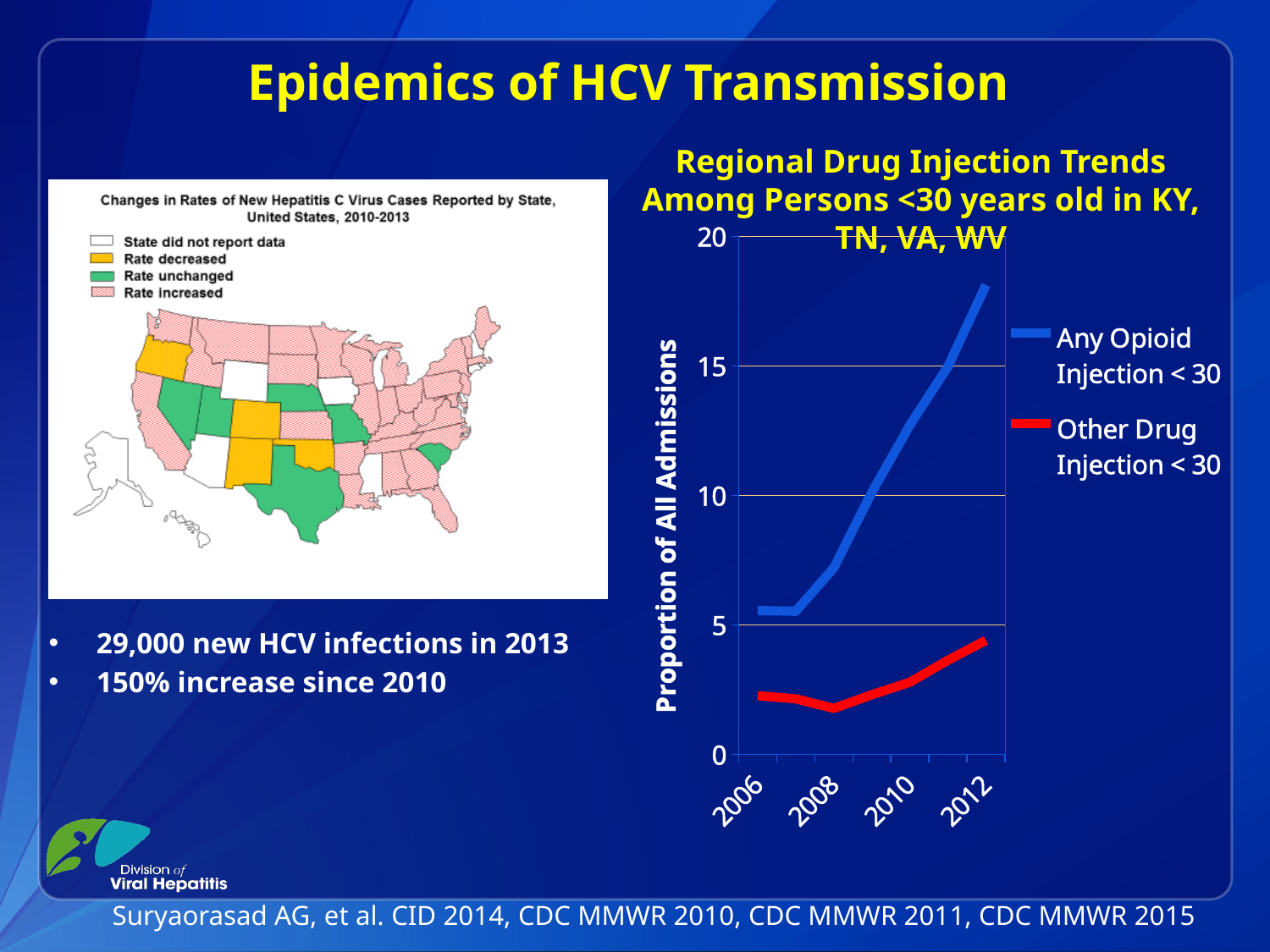
In the 'Regional Drug Injection Trends' chart, what are the two series named in the legend? Any Opioid Injection < 30 and Other Drug Injection < 30 In the 'Regional Drug Injection Trends' chart, is the value for Other Drug Injection < 30 in 2008 greater or less than 5? less In the 'Regional Drug Injection Trends' chart, is the value for Any Opioid Injection < 30 in 2010 greater or less than 10? greater In the 'Regional Drug Injection Trends' chart, what is the label on the vertical axis? Proportion of All Admissions In the 'Regional Drug Injection Trends' chart, which series has the higher value in 2012, Any Opioid Injection < 30 or Other Drug Injection < 30? Any Opioid Injection < 30 In the 'Regional Drug Injection Trends' chart, is the value for Other Drug Injection < 30 in 2012 greater or less than 5? less In the 'Regional Drug Injection Trends' chart, does the Any Opioid Injection < 30 line rise or fall from 2006 to 2012? Rise How many series does the legend of the 'Regional Drug Injection Trends' chart list? 2 What kind of chart is the 'Regional Drug Injection Trends' chart on the right of the slide? Line chart How many years are labeled on the x axis of the 'Regional Drug Injection Trends' chart? 4